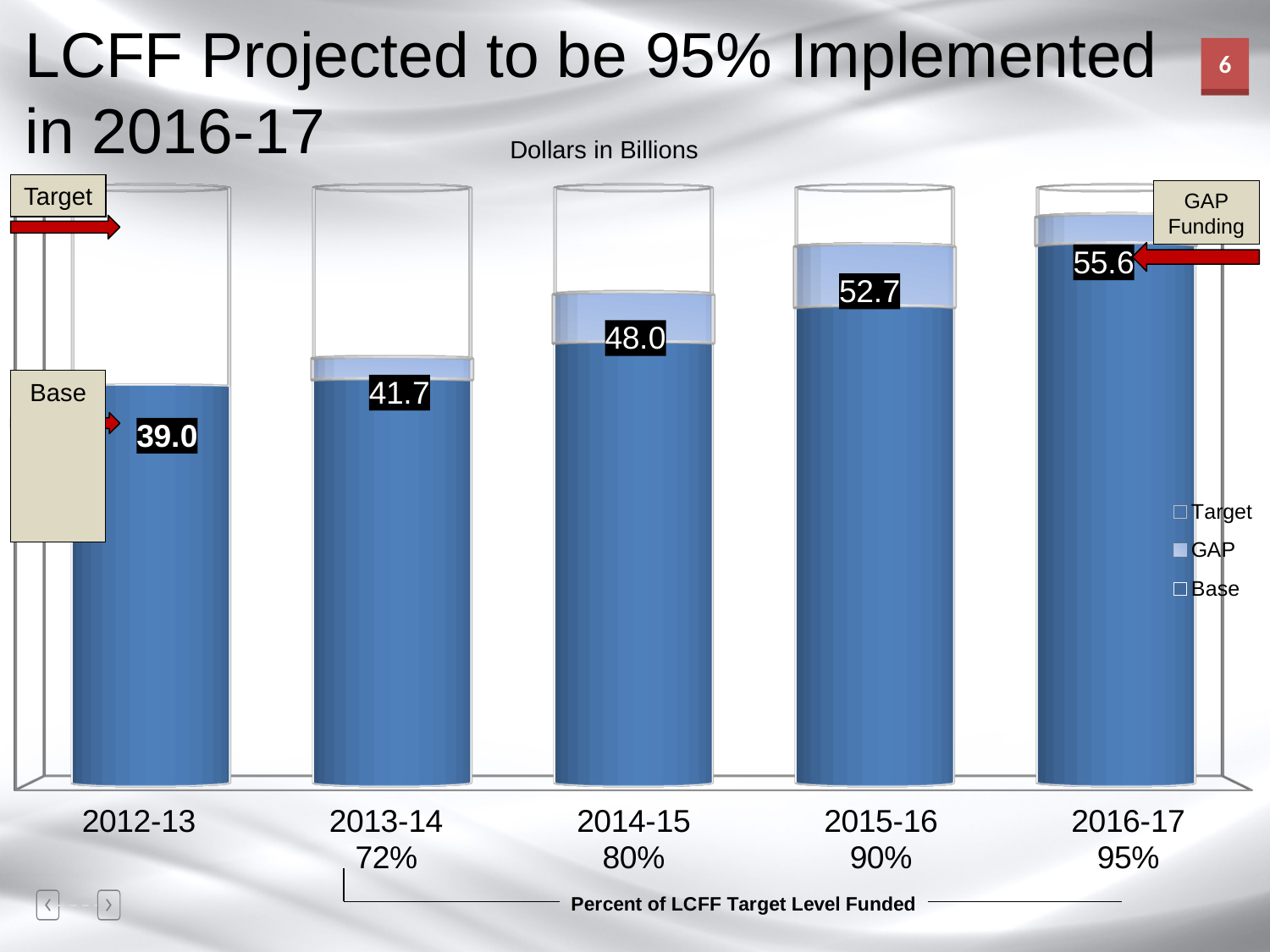
What is the difference between the labeled values for 2016-17 and 2012-13? 16.6 What value is labeled on the bar for 2014-15? 48.0 What value is labeled on the bar for 2016-17? 55.6 What percent of the LCFF target level is funded in 2015-16? 90% What is the difference between the labeled values for 2014-15 and 2013-14? 6.3 How many series does the legend list? 3 Do the labeled values rise or fall from 2012-13 to 2016-17? rise What value is labeled on the bar for 2012-13? 39.0 How many years are shown on the x axis? 5 Which is larger, the labeled value for 2015-16 or for 2013-14? 2015-16 Which year has the highest labeled value? 2016-17 Which year has the lowest labeled value? 2012-13